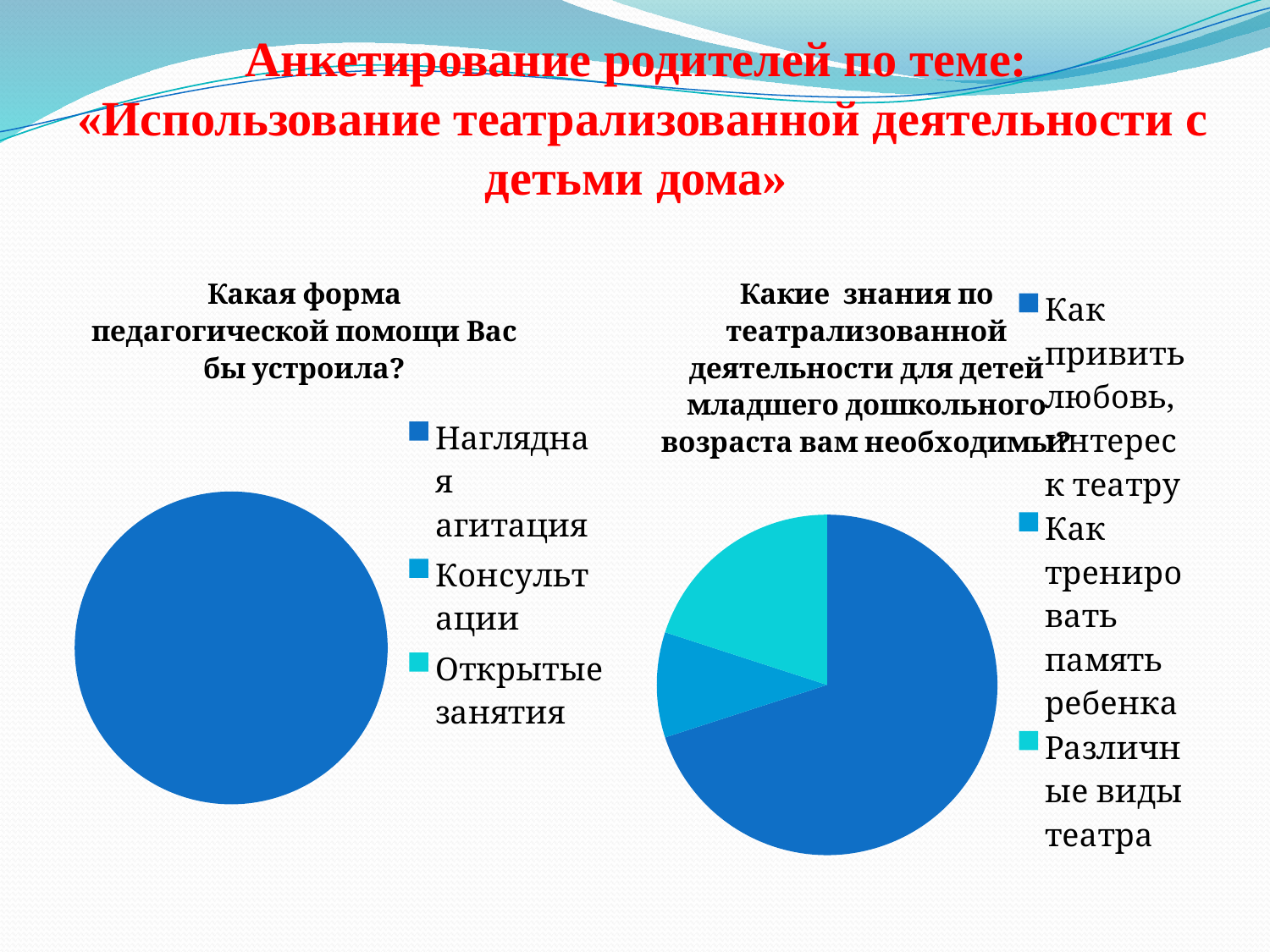
In the right chart «Какие знания по театрализованной деятельности...», which slice is larger: «Как привить любовь, интерес к театру» or «Различные виды театра»? Как привить любовь, интерес к театру In the right chart «Какие знания по театрализованной деятельности...», how many categories does the legend list? 3 What kind of chart is the left chart titled «Какая форма педагогической помощи Вас бы устроила?»? Pie chart In the right chart «Какие знания по театрализованной деятельности...», which slice is larger: «Различные виды театра» or «Как тренировать память ребенка»? Различные виды театра In the right chart «Какие знания по театрализованной деятельности...», which category has the smallest share of the pie? Как тренировать память ребенка What kind of chart is the right chart titled «Какие знания по театрализованной деятельности для детей младшего дошкольного возраста вам необходимы?»? Pie chart In the left chart «Какая форма педагогической помощи Вас бы устроила?», which legend entry is listed last? Открытые занятия In the right chart, what colour is the slice for «Различные виды театра»? Light teal In the left chart «Какая форма педагогической помощи Вас бы устроила?», which category has the largest share of the pie? Наглядная агитация In the left chart «Какая форма педагогической помощи Вас бы устроила?», how many categories does the legend list? 3 In the right chart «Какие знания по театрализованной деятельности...», which category has the largest share of the pie? Как привить любовь, интерес к театру